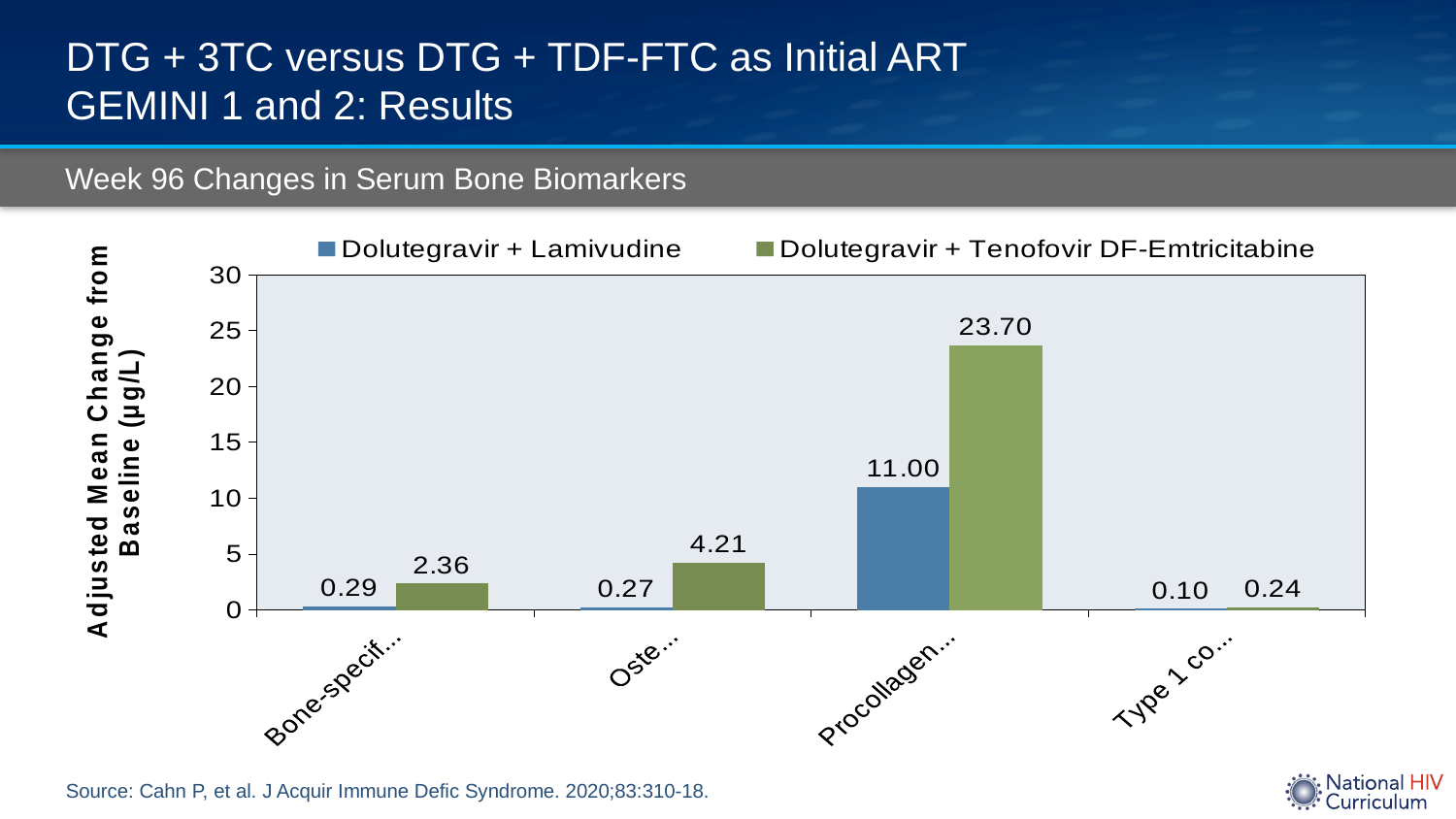
What is the value for Dolutegravir + Tenofovir DF-Emtricitabine in the third category (labeled 'Procollagen...')? 23.70 What type of chart is shown on the slide? bar chart What is the difference between the two series in the third category (labeled 'Procollagen...')? 12.70 What is the value for Dolutegravir + Tenofovir DF-Emtricitabine in the second category (labeled 'Oste...')? 4.21 Which category has the lowest value for Dolutegravir + Lamivudine? Type 1 co... (fourth category) What is the value for Dolutegravir + Lamivudine in the first category (labeled 'Bone-specif...')? 0.29 Which category has the highest value for Dolutegravir + Tenofovir DF-Emtricitabine? Procollagen... (third category) What is the y-axis title of the chart? Adjusted Mean Change from Baseline (µg/L) What is the value for Dolutegravir + Lamivudine in the third category (labeled 'Procollagen...')? 11.00 How many series does the legend list? 2 In the first category (labeled 'Bone-specif...'), which series has the larger value? Dolutegravir + Tenofovir DF-Emtricitabine How many biomarker categories are shown on the x axis? 4